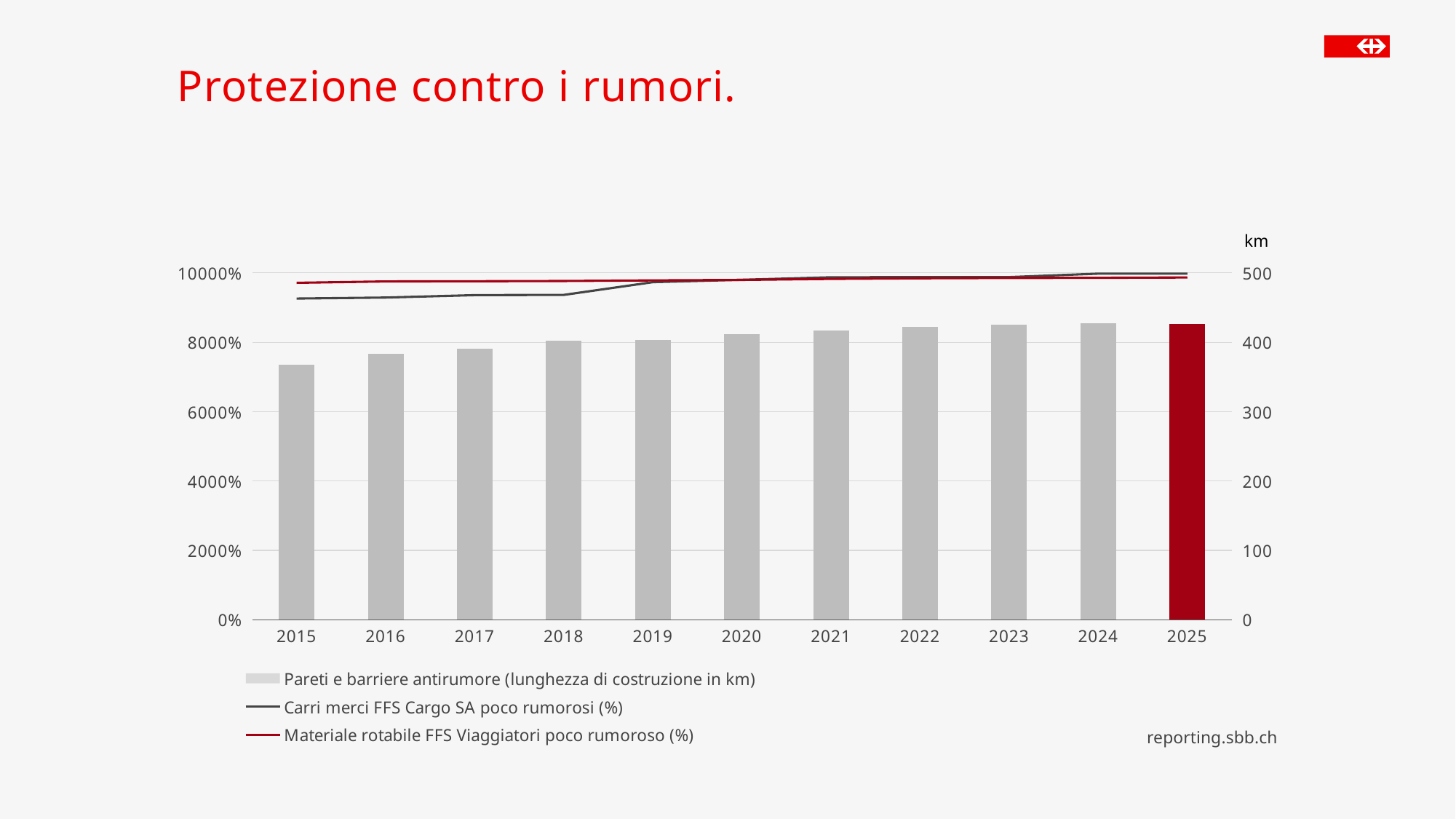
Which bar is shown in a different colour (dark red) from the others? 2025 Do the bars for Pareti e barriere antirumore rise or fall from 2015 to 2025? Rise How many series does the chart legend list? 3 Does the line for Carri merci FFS Cargo SA poco rumorosi rise or fall from 2015 to 2025? Rise How many years are shown on the x axis of the chart? 11 Is the value for Pareti e barriere antirumore in 2016 greater or less than 400 km? less Which year has the lowest bar for Pareti e barriere antirumore? 2015 Is the value for Pareti e barriere antirumore in 2015 greater or less than 400 km? less Is the value for Pareti e barriere antirumore in 2025 greater or less than 400 km? greater What kind of chart is shown on the slide? Combined bar and line chart What is the title of the chart on the slide? Protezione contro i rumori. In 2015, which line is higher: Carri merci FFS Cargo SA poco rumorosi or Materiale rotabile FFS Viaggiatori poco rumoroso? Materiale rotabile FFS Viaggiatori poco rumoroso